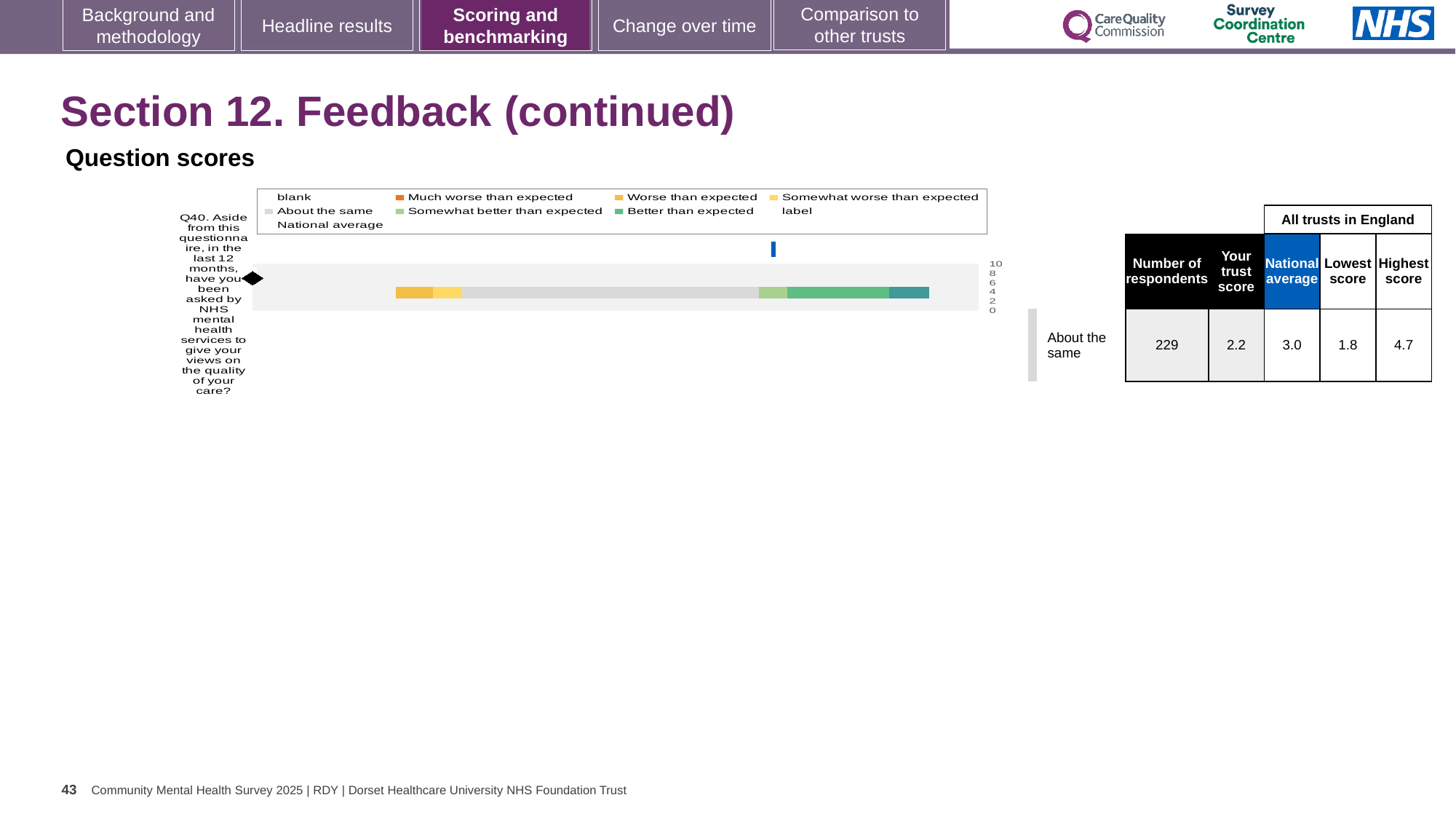
In the table beside the chart, what is the national average for Q40? 3.0 In the table beside the chart, what is the number of respondents for Q40? 229 What rating category is shown beside the bar for Q40? About the same Which legend entry in the Question scores chart is shown in orange? Much worse than expected In the table beside the chart, what is the highest score among all trusts in England for Q40? 4.7 In the table beside the chart, what is the trust's score for Q40? 2.2 In the table beside the chart, what is the lowest score among all trusts in England for Q40? 1.8 How many entries does the legend of the Question scores chart list? 9 What kind of chart is shown under 'Question scores'? bar chart Which question is plotted in the Question scores chart? Q40. Aside from this questionnaire, in the last 12 months, have you been asked by NHS mental health services to give your views on the quality of your care? In the table beside the chart, which is larger for Q40: the trust's score or the national average? national average How many questions (categories) are plotted in the Question scores chart? 1